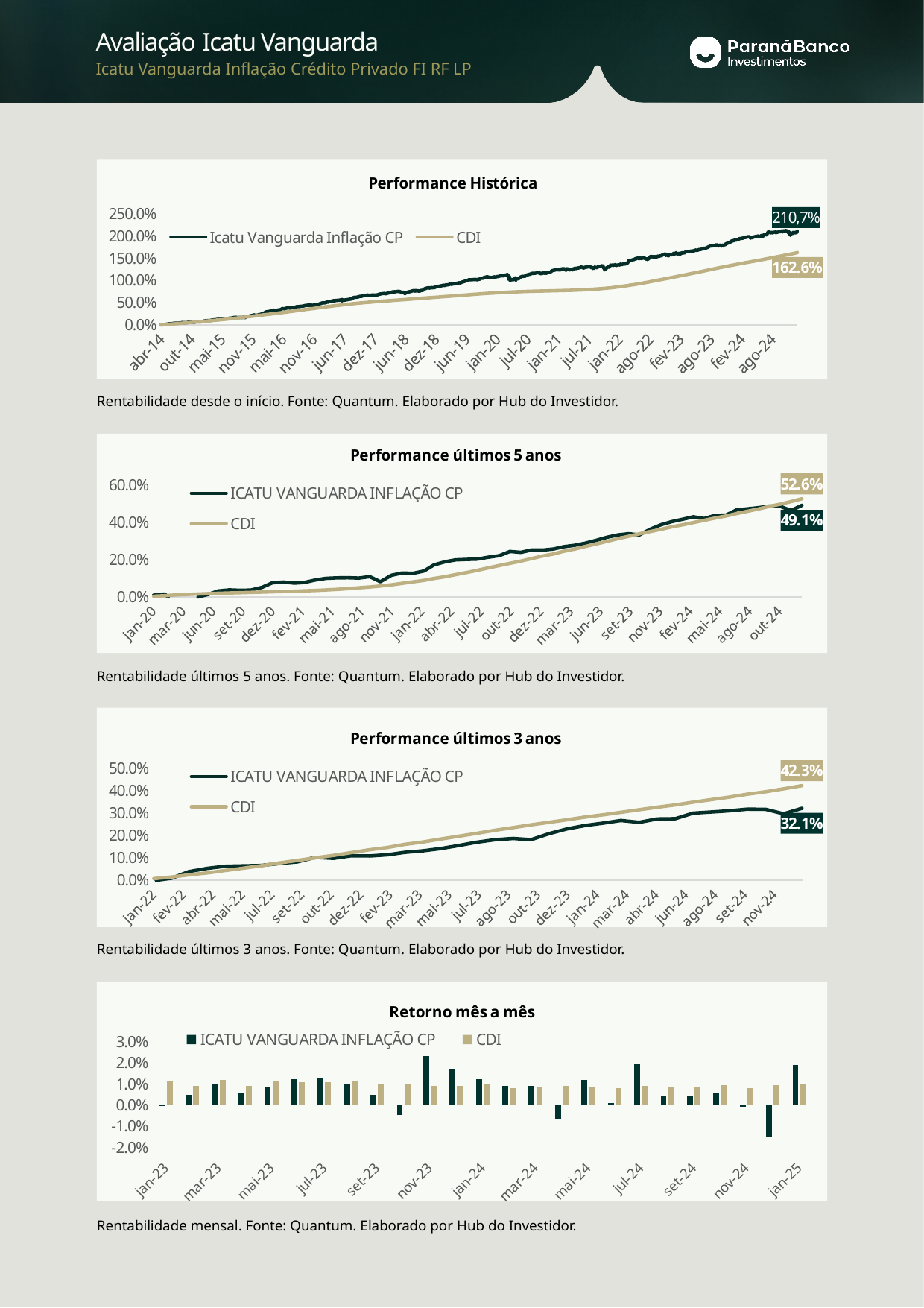
In the 'Performance últimos 3 anos' chart, what is the final value shown for ICATU VANGUARDA INFLAÇÃO CP? 32.1% In the 'Performance últimos 3 anos' chart, which series ends higher, ICATU VANGUARDA INFLAÇÃO CP or CDI? CDI In the 'Performance Histórica' chart, what is the final value shown for CDI? 162.6% How many series does the legend of the 'Retorno mês a mês' chart list? 2 What kind of chart is 'Retorno mês a mês'? bar chart In the 'Performance Histórica' chart, what is the final value shown for Icatu Vanguarda Inflação CP? 210,7% In the 'Performance Histórica' chart, do the values rise or fall over time along the x axis? rise In the 'Performance últimos 5 anos' chart, what is the difference between the final CDI value and the final ICATU VANGUARDA INFLAÇÃO CP value? 3.5 percentage points In the 'Performance últimos 5 anos' chart, what is the final value shown for CDI? 52.6% In the 'Performance últimos 3 anos' chart, what is the final value shown for CDI? 42.3% In the 'Performance Histórica' chart, which series ends higher, Icatu Vanguarda Inflação CP or CDI? Icatu Vanguarda Inflação CP In the 'Performance últimos 5 anos' chart, what is the final value shown for ICATU VANGUARDA INFLAÇÃO CP? 49.1%